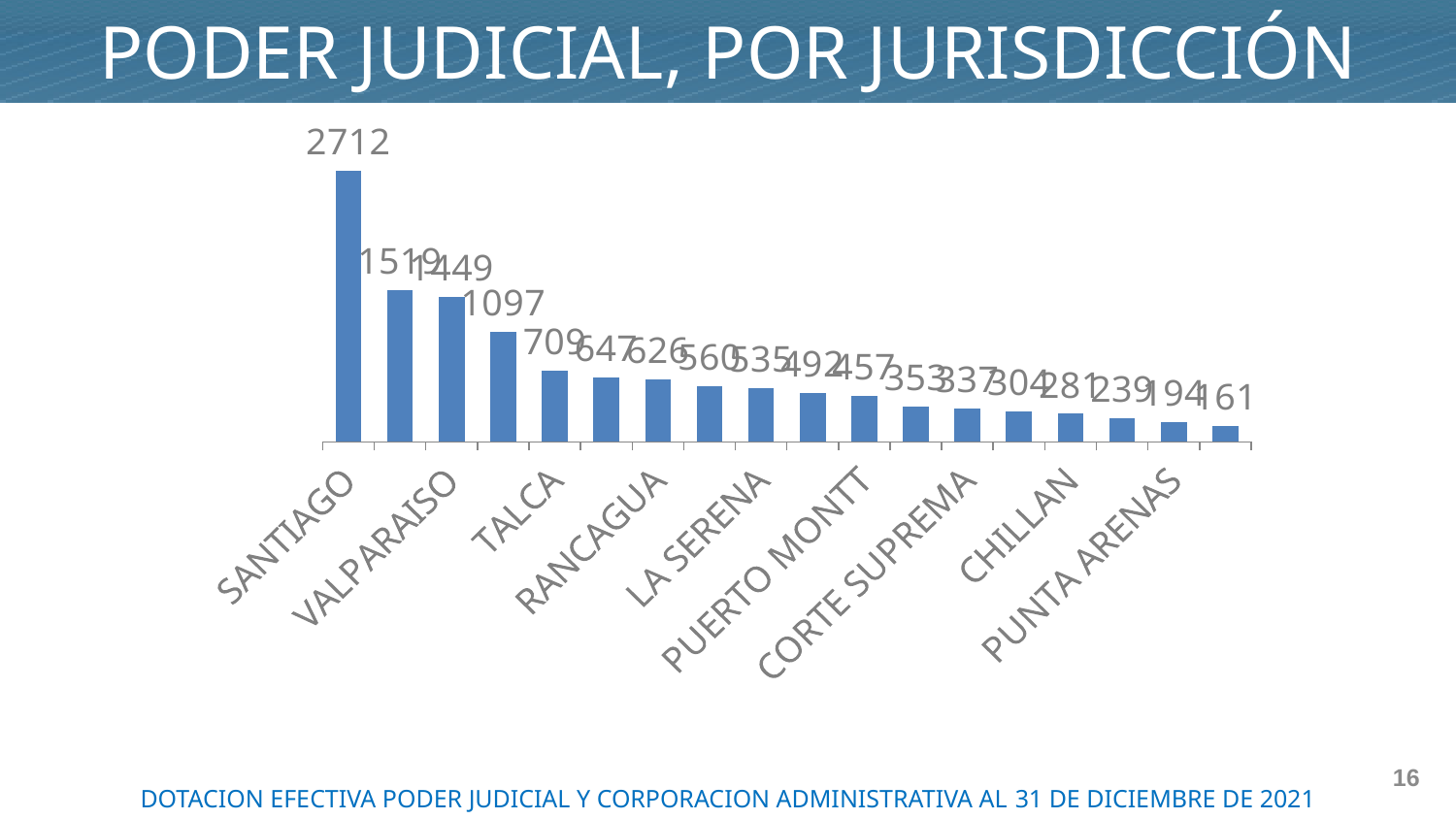
Do the values rise or fall from left to right along the x axis? Fall What kind of chart is shown on the slide? Bar chart Which jurisdiction has the highest value? SANTIAGO What is the value for TALCA? 709 What is the value for PUNTA ARENAS? 194 Which is larger, the value for TALCA or the value for RANCAGUA? TALCA What is the value for CORTE SUPREMA? 337 What is the value for SANTIAGO? 2712 How many bars are plotted on the chart? 18 What is the difference between the values for SANTIAGO and VALPARAISO? 1263 What is the value for VALPARAISO? 1449 What is the smallest value shown on the chart? 161